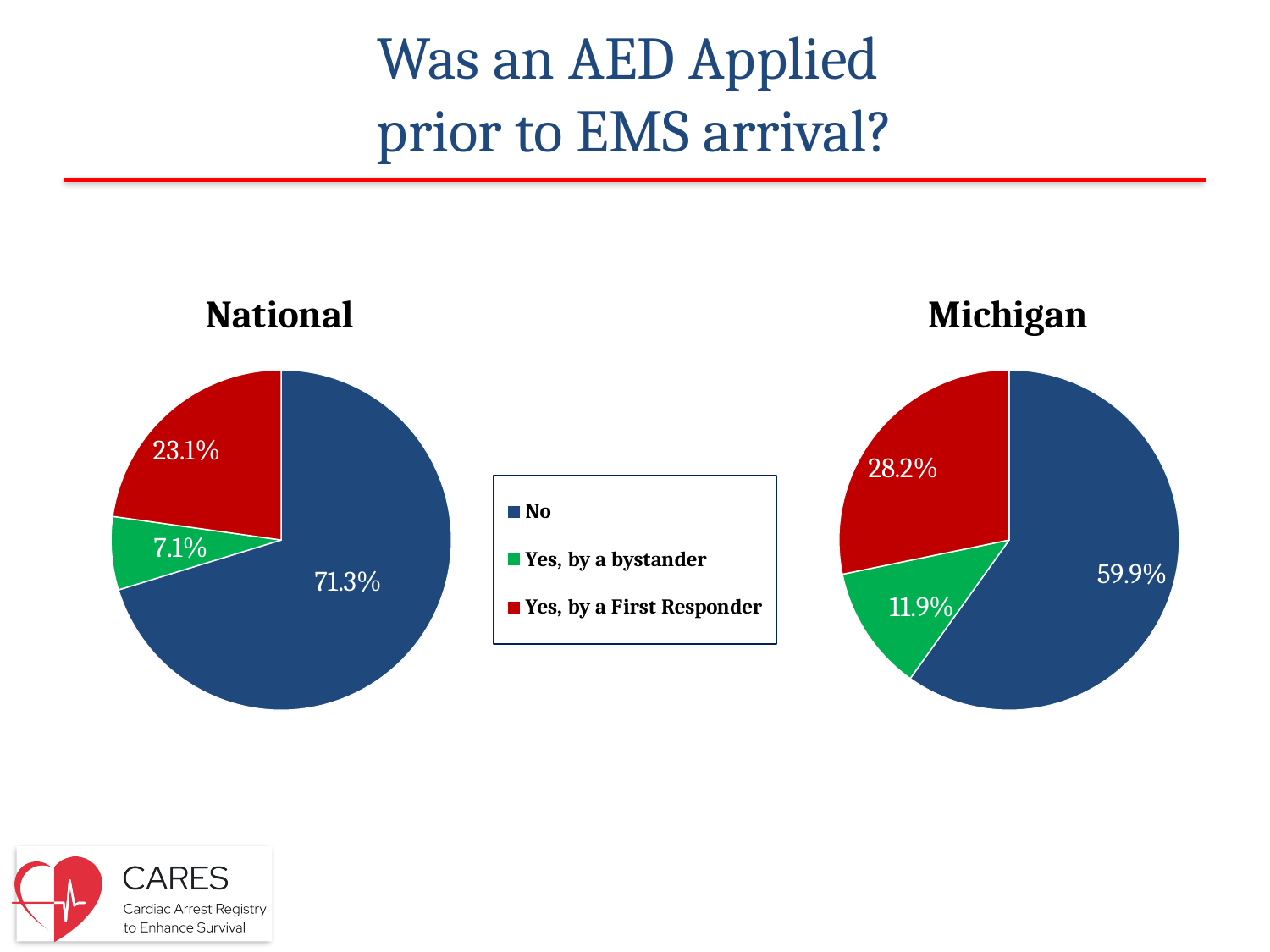
In the National pie chart, what percentage is shown for 'Yes, by a bystander'? 7.1% What is the difference between the 'No' share in the National chart and the 'No' share in the Michigan chart? 11.4% In the Michigan pie chart, what percentage is shown for 'Yes, by a bystander'? 11.9% How many slices does the Michigan pie chart have? 3 In the National pie chart, what share of cases had no AED applied prior to EMS arrival? 71.3% In the Michigan pie chart, which category has the smallest slice? Yes, by a bystander In the National pie chart, which category has the largest slice? No Which chart shows a larger share for 'Yes, by a First Responder', National or Michigan? Michigan What type of chart is used for the National data? Pie chart How many entries does the legend list? 3 What colour represents 'Yes, by a First Responder' in the legend? Red In the Michigan pie chart, what percentage is shown for 'Yes, by a First Responder'? 28.2%